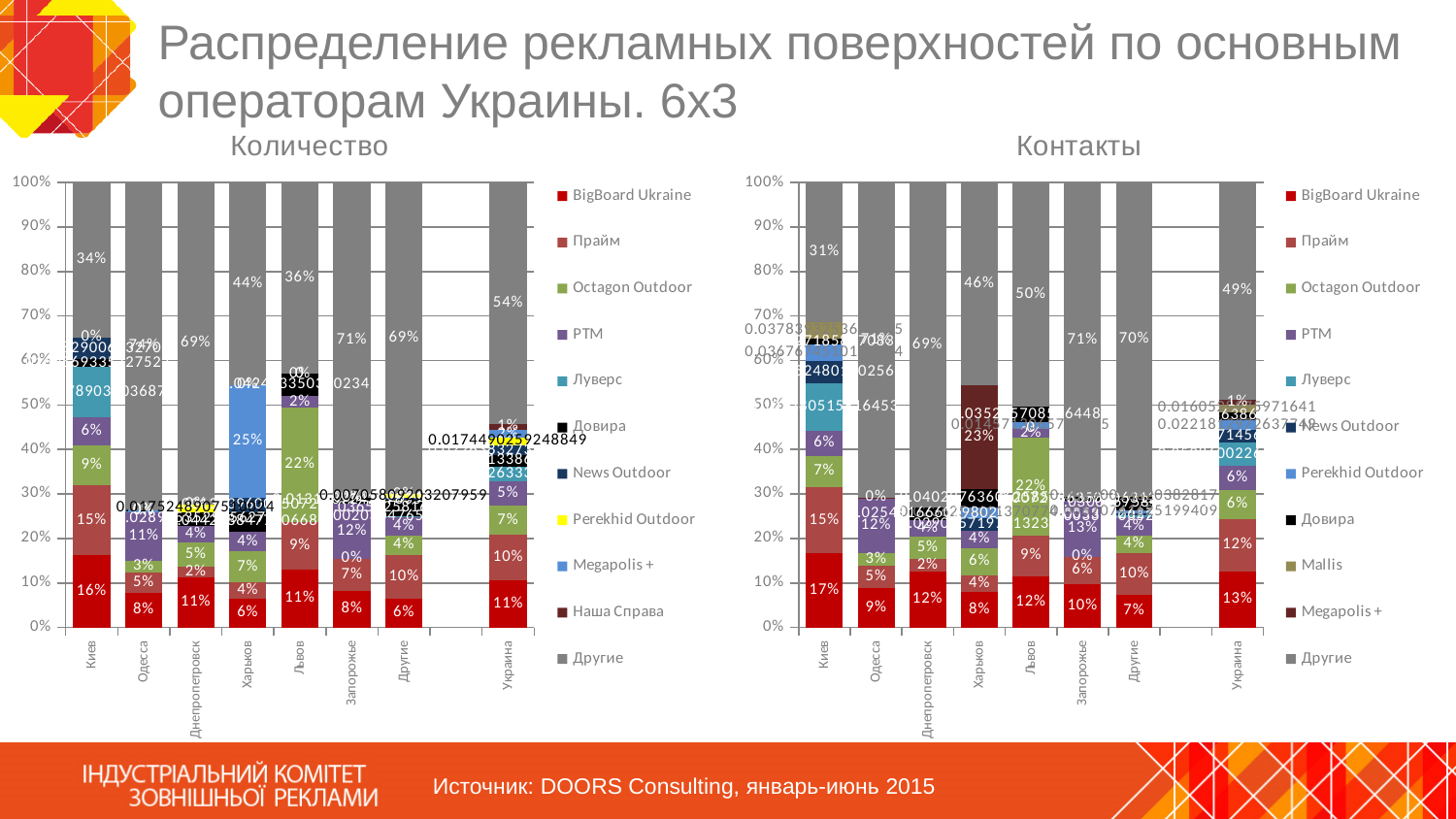
What type of chart is the "Количество" chart? Stacked bar chart How many categories are shown on the x axis of the "Количество" chart? 8 On the "Количество" chart, what is the difference between the Другие values for Украина and Киев? 20% On the "Контакты" chart, what is the value for BigBoard Ukraine in Украина? 13% On the "Контакты" chart, which is larger: BigBoard Ukraine in Киев or BigBoard Ukraine in Другие? Киев On the "Количество" chart, what is the value for BigBoard Ukraine in Киев? 16% On the "Контакты" chart, what is the value for Octagon Outdoor in Львов? 22% On the "Количество" chart, what is the value for Megapolis + in Харьков? 25% On the "Контакты" chart, what is the value for Другие in Запорожье? 71% How many series does the legend of the "Контакты" chart list? 11 On the "Количество" chart, which city has the highest value for Другие? Одесса On the "Количество" chart, what is the value for Другие in Харьков? 44%